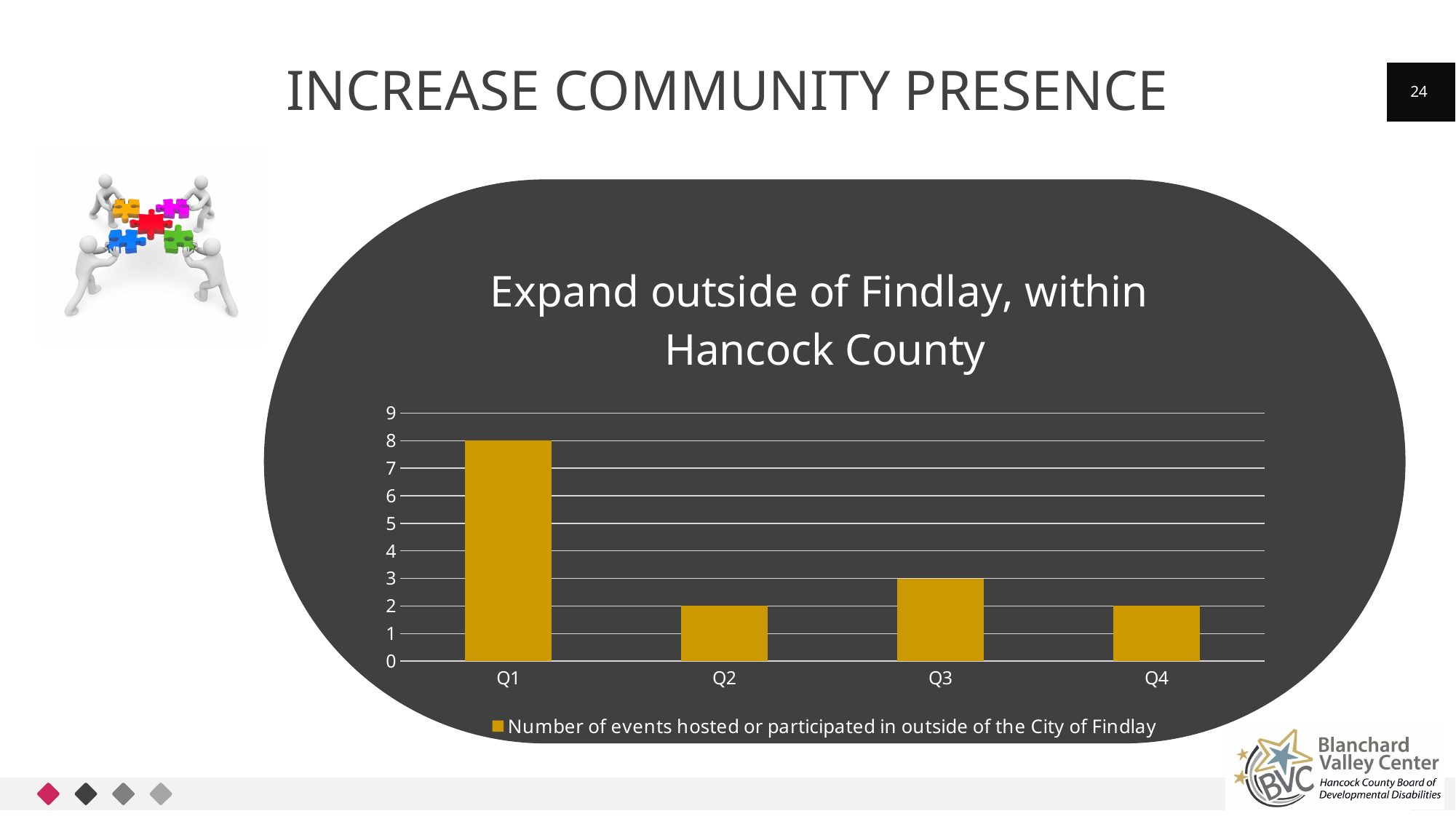
What is the value for Q3? 3 What is the number of events hosted or participated in outside of the City of Findlay in Q1? 8 How many series does the legend list? 1 What is the title of the chart? Expand outside of Findlay, within Hancock County What is the difference between the values for Q1 and Q3? 5 Which quarter has the highest number of events? Q1 Do the values rise or fall from Q1 to Q2? fall Which is larger, the value for Q3 or the value for Q4? Q3 How many quarters are shown on the x axis? 4 What type of chart is shown on the slide? bar chart What is the value for Q2? 2 Is the value for Q1 greater or less than 5? greater